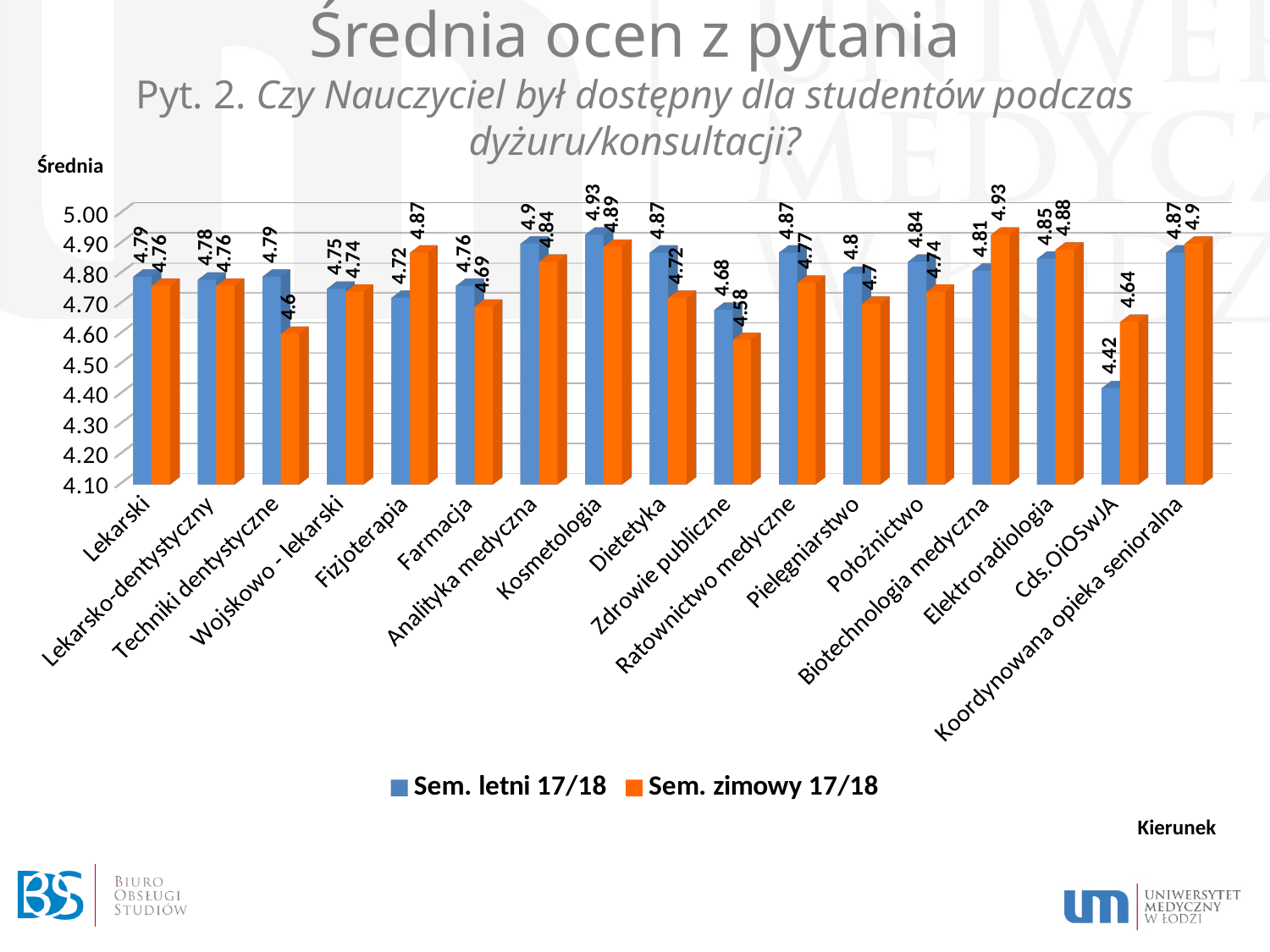
What is the label of the y axis? Średnia Which category has the lowest value in Sem. zimowy 17/18? Zdrowie publiczne Which category has the highest value in Sem. zimowy 17/18? Biotechnologia medyczna What is the value for Kosmetologia in Sem. letni 17/18? 4.93 Is the Sem. letni 17/18 value for Cds.OiOSwJA greater or less than 4.50? less Which category has the lowest value in Sem. letni 17/18? Cds.OiOSwJA What is the value for Cds.OiOSwJA in Sem. zimowy 17/18? 4.64 For Fizjoterapia, which series has the larger value: Sem. letni 17/18 or Sem. zimowy 17/18? Sem. zimowy 17/18 What is the difference between the Sem. letni 17/18 and Sem. zimowy 17/18 values for Techniki dentystyczne? 0.19 How many categories (kierunki) are shown on the x axis? 17 What type of chart is shown on the slide? bar chart How many series does the legend list? 2